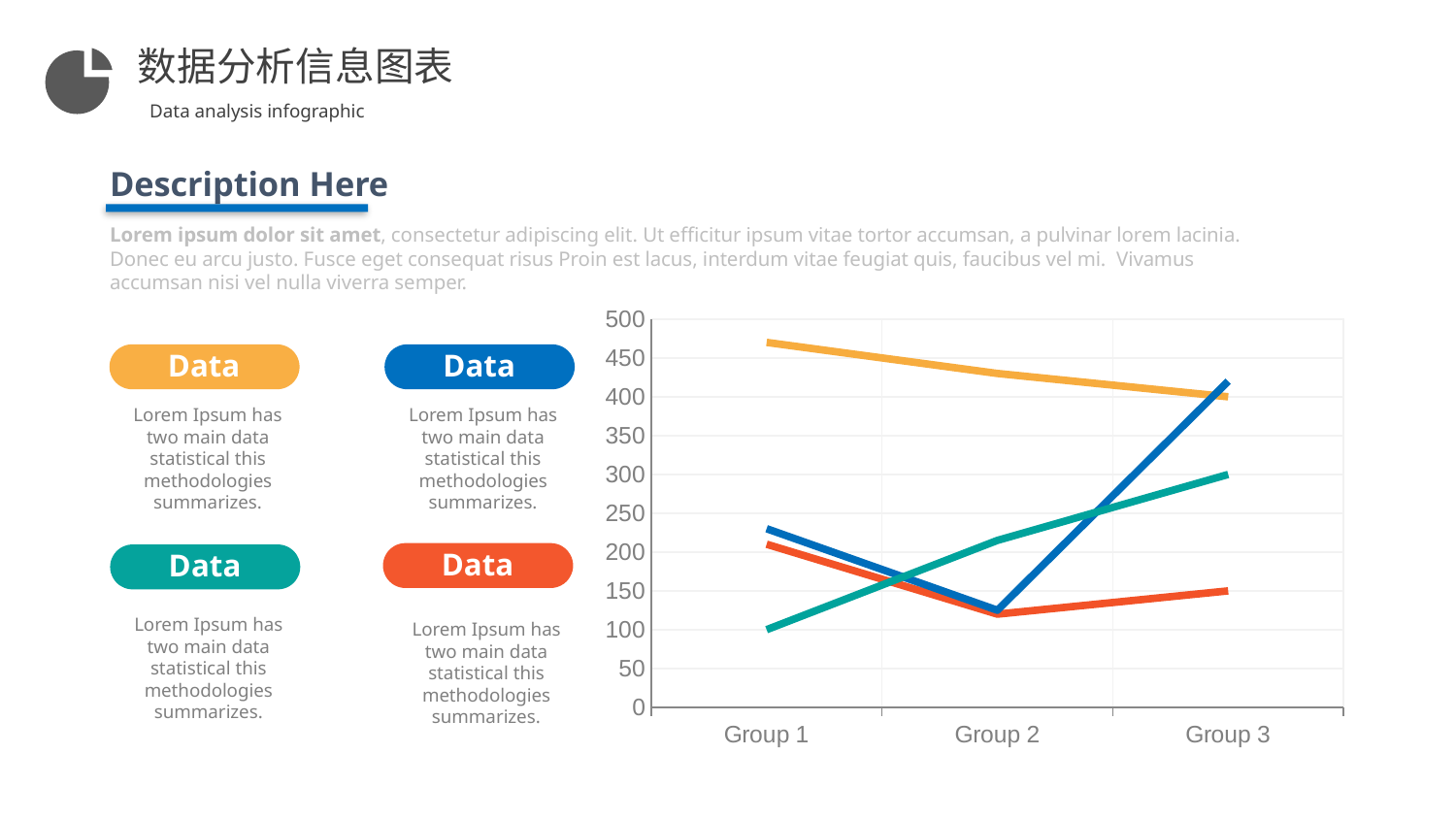
How many lines are plotted on the chart? 4 Does the yellow line rise or fall from Group 1 to Group 3? fall Does the teal line rise or fall from Group 1 to Group 3? rise Is the value of the yellow line at Group 1 greater or less than 450? greater Which line has the highest value at Group 1? the yellow line Is the value of the blue line at Group 2 greater or less than 150? less At Group 3, which is larger: the value of the teal line or the value of the red line? the teal line What kind of chart is shown on the slide? line chart What are the category labels on the x axis of the chart? Group 1, Group 2, Group 3 How many categories are shown on the x axis of the chart? 3 Which line has the lowest value at Group 1? the teal line Which line has the highest value at Group 3? the blue line